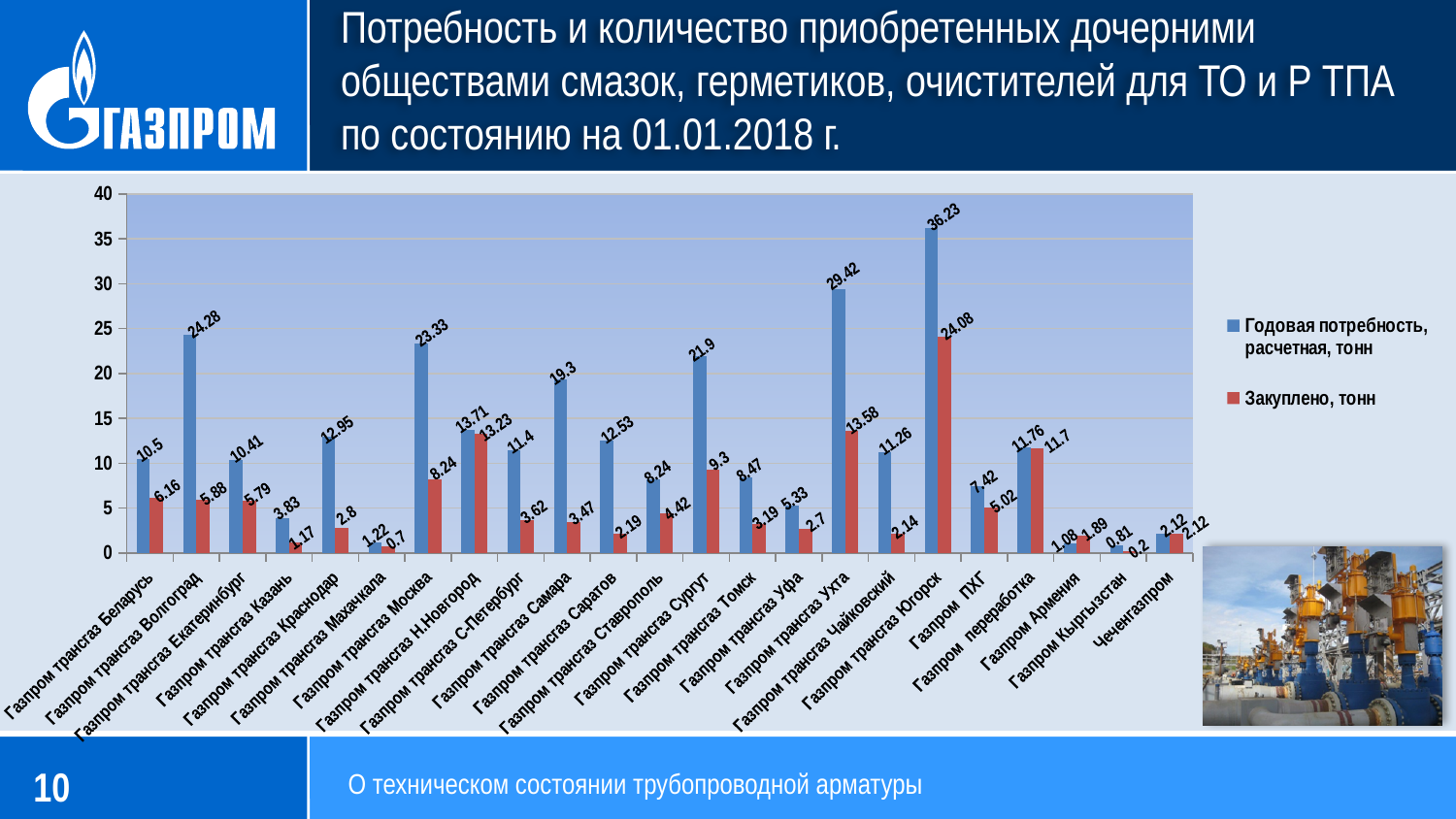
What is the purchased amount (Закуплено, тонн) for Газпром трансгаз Ухта? 13.58 How many subsidiaries (categories) are shown on the x axis? 23 What kind of chart is shown on the slide? Bar chart What is the difference between the annual need and the purchased amount for Газпром трансгаз Югорск? 12.15 Which subsidiary has the highest annual calculated need (Годовая потребность)? Газпром трансгаз Югорск Is the annual calculated need for Газпром трансгаз Ухта greater or less than 25? greater Which subsidiary has the lowest purchased amount (Закуплено)? Газпром Кыргызстан How many series does the legend list? 2 What is the annual calculated need (Годовая потребность) for Газпром трансгаз Волгоград? 24.28 What is the difference between the annual need and the purchased amount for Газпром трансгаз Волгоград? 18.4 Which is larger for Газпром Армения: the annual calculated need or the purchased amount? Purchased amount (Закуплено) What is the annual calculated need (Годовая потребность, расчетная, тонн) for Газпром трансгаз Югорск? 36.23